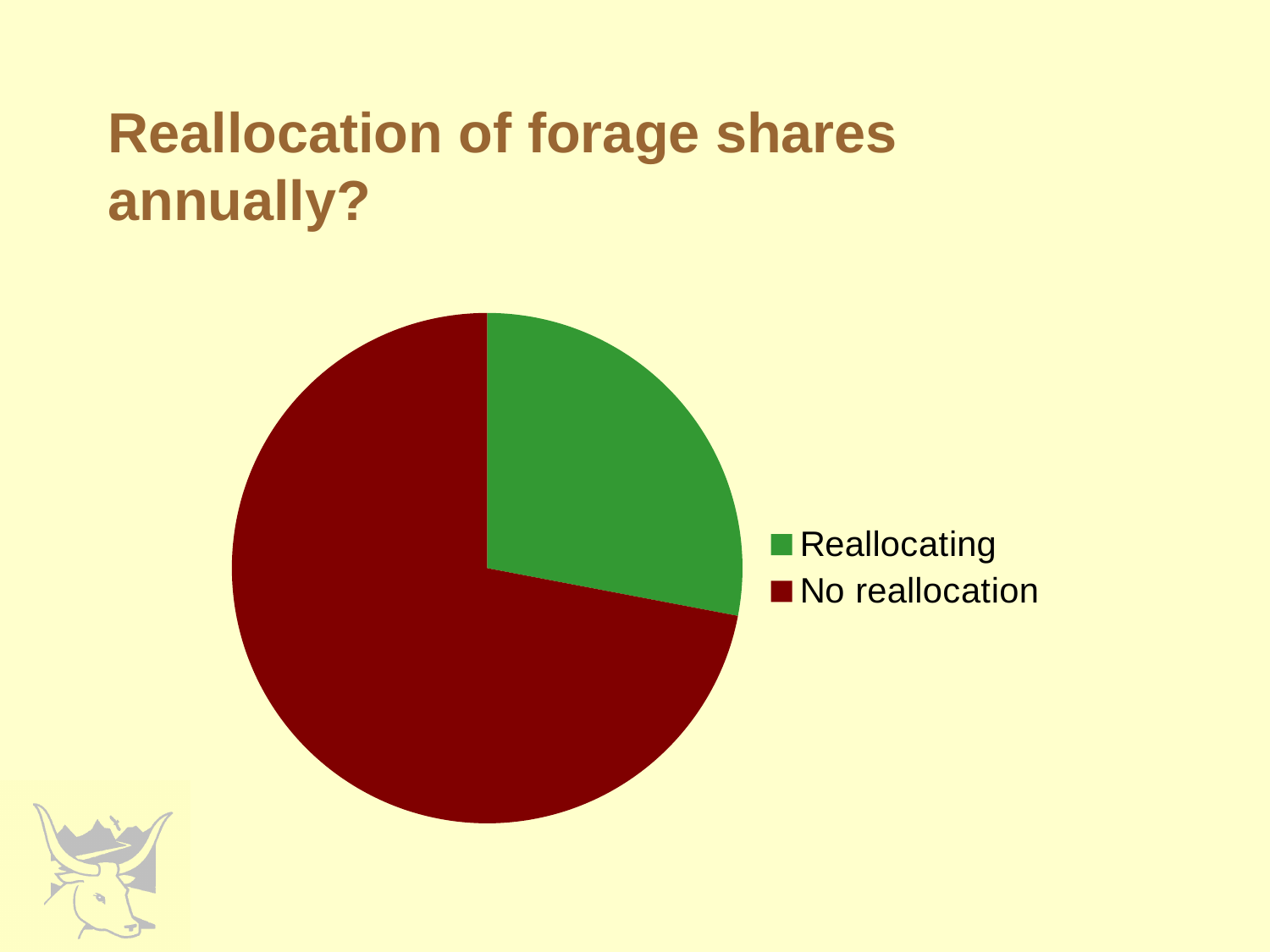
Which slice of the pie chart is the smallest? Reallocating What is the title of the slide containing the pie chart? Reallocation of forage shares annually? Which slice of the pie chart is the largest? No reallocation Does the Reallocating slice make up more or less than half of the pie chart? Less What colour is the Reallocating slice in the pie chart? Green What kind of chart is shown on the slide? Pie chart How many entries does the legend of the pie chart list? 2 How many slices does the pie chart have? 2 Which is larger in the pie chart, the Reallocating slice or the No reallocation slice? No reallocation